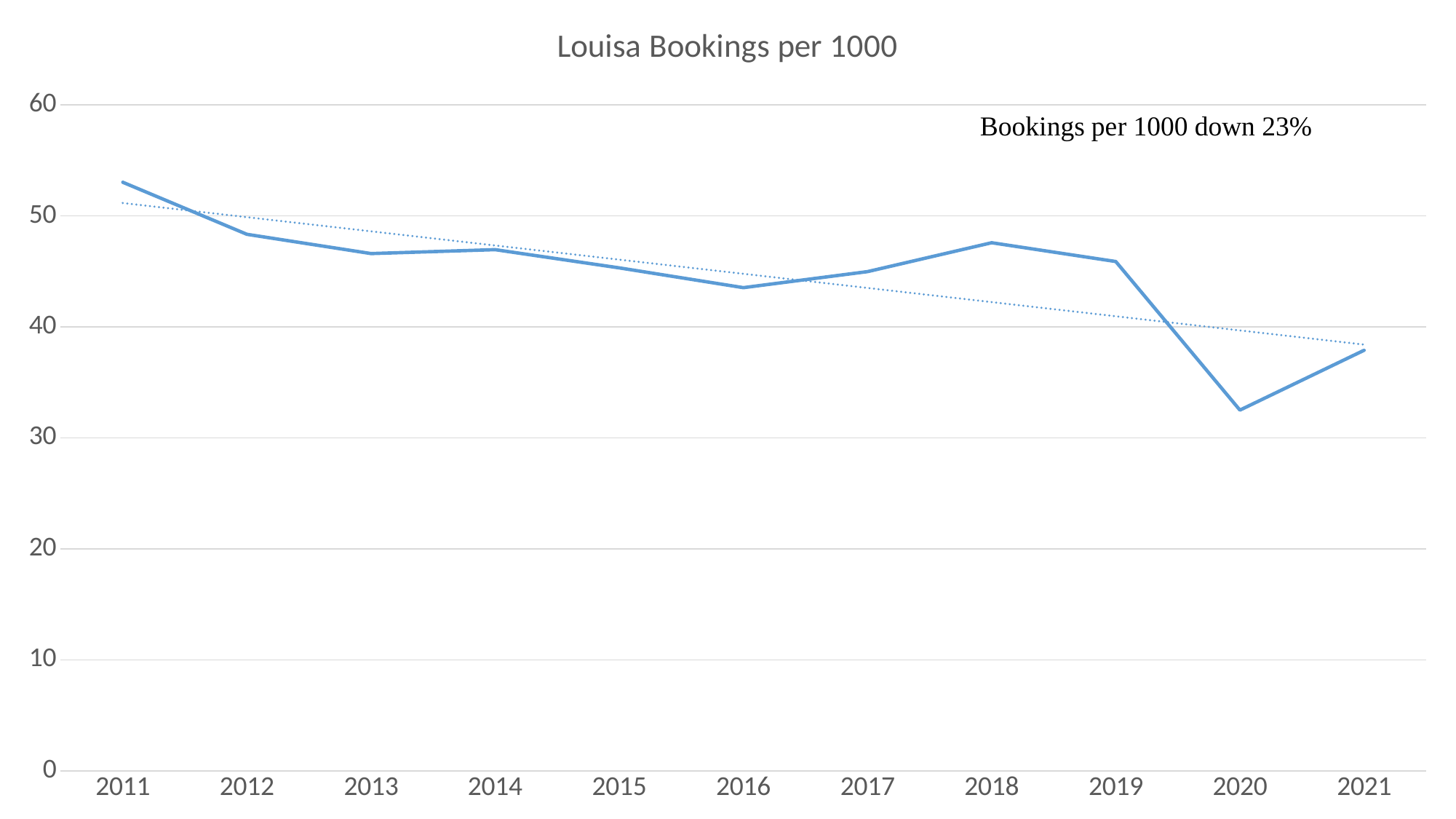
Is the value for 2018 greater or less than 50? less Is the value for 2011 greater or less than 50? greater Which year has the higher value, 2011 or 2021? 2011 Is the value for 2020 greater or less than 40? less What kind of chart is shown on the slide? line chart Which year has the higher value, 2020 or 2021? 2021 What is the title of the chart? Louisa Bookings per 1000 How many years are plotted along the x axis? 11 Do bookings per 1000 generally rise or fall from 2011 to 2021? fall Which year has the highest bookings per 1000? 2011 Which year has the lowest bookings per 1000? 2020